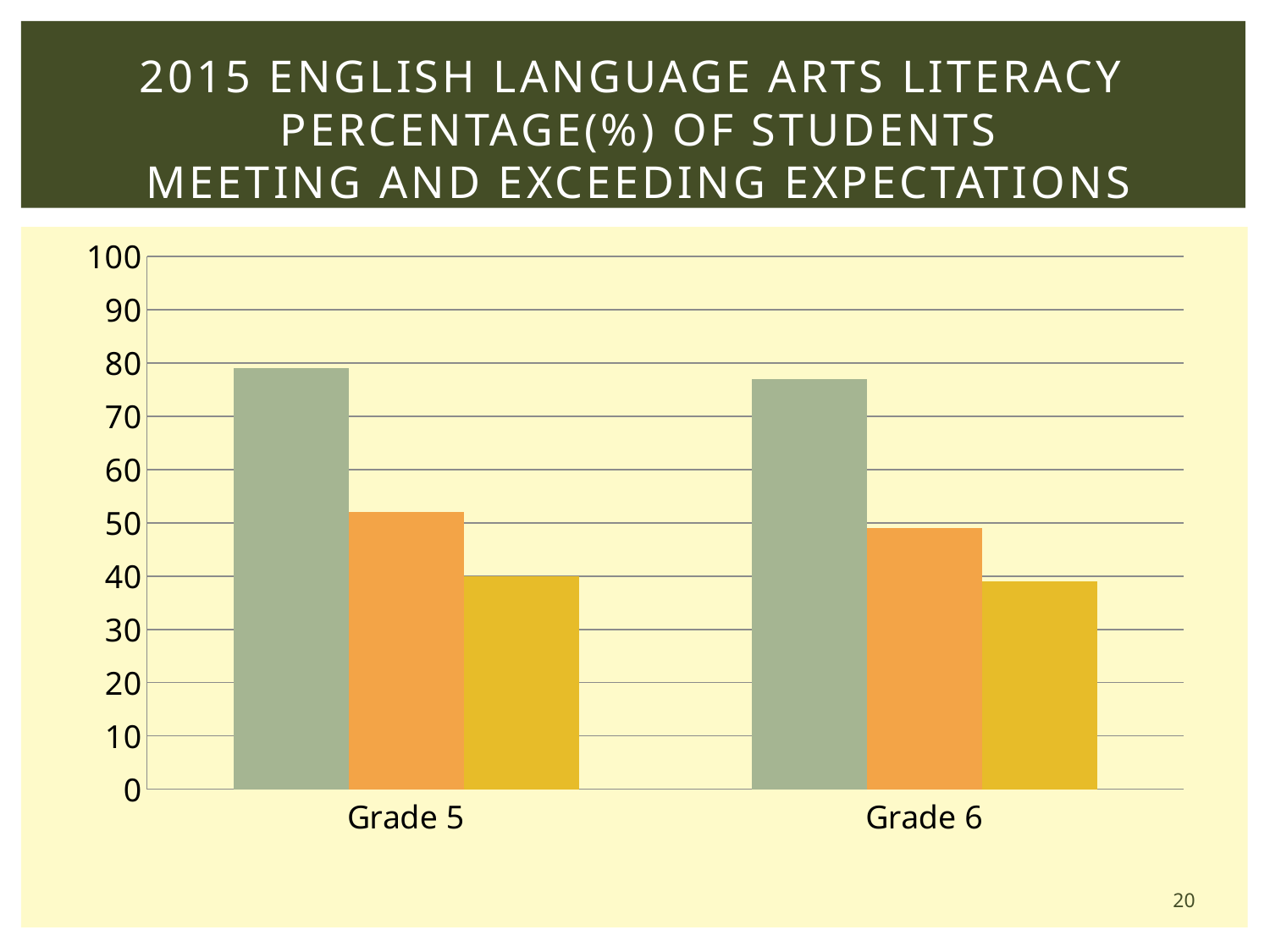
What kind of chart is shown on the slide? bar chart Which bar is the shortest for Grade 6? the yellow bar How many grade categories are shown on the x axis? 2 Is the value of the orange bar for Grade 6 greater or less than 40? greater Which is larger, the orange bar for Grade 5 or the orange bar for Grade 6? Grade 5 Is the value of the green bar for Grade 6 greater or less than 80? less What year does the chart title refer to? 2015 Is the value of the orange bar for Grade 5 greater or less than 60? less Which bar is the tallest for Grade 5? the green bar How many bars are plotted for each grade? 3